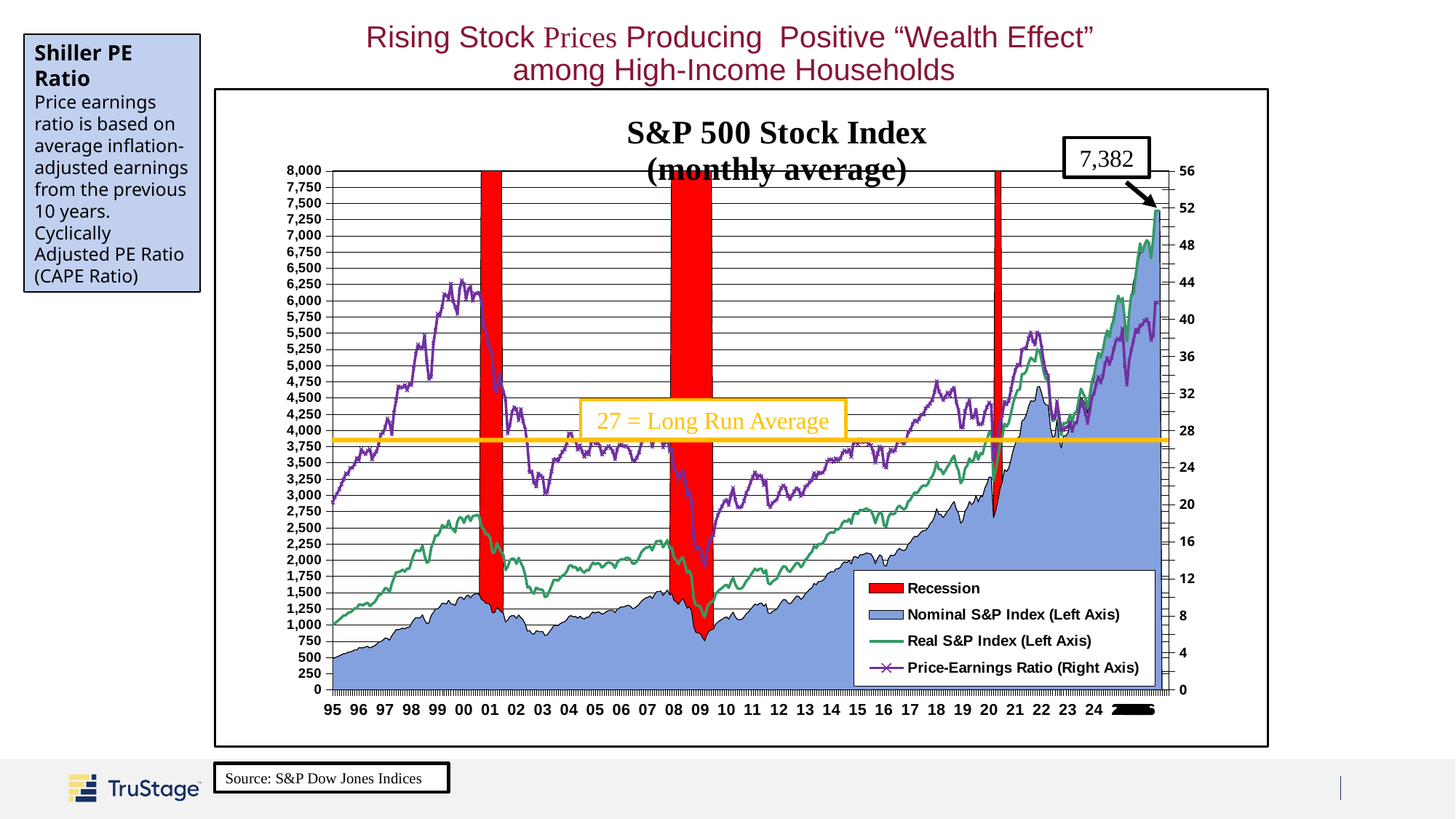
Is the Price-Earnings Ratio at its 2009 low greater or less than 16? less What is the title of the chart? S&P 500 Stock Index (monthly average) Does the Nominal S&P Index generally rise or fall from 1995 to 2024? rise What value is given as the long run average of the Price-Earnings Ratio? 27 What is the labeled value of the Nominal S&P Index at the end of the series? 7,382 Is the Nominal S&P Index value in 1995 greater or less than 1,000? less How many recession periods are shaded on the chart? 3 Is the Real S&P Index at its 2000 peak greater or less than 2,500? greater On which axis is the Price-Earnings Ratio plotted? Right Axis What kind of chart is shown on the slide? combination area and line chart How many entries does the chart legend list? 4 Which is higher, the Price-Earnings Ratio around 2000 or around 2009? around 2000